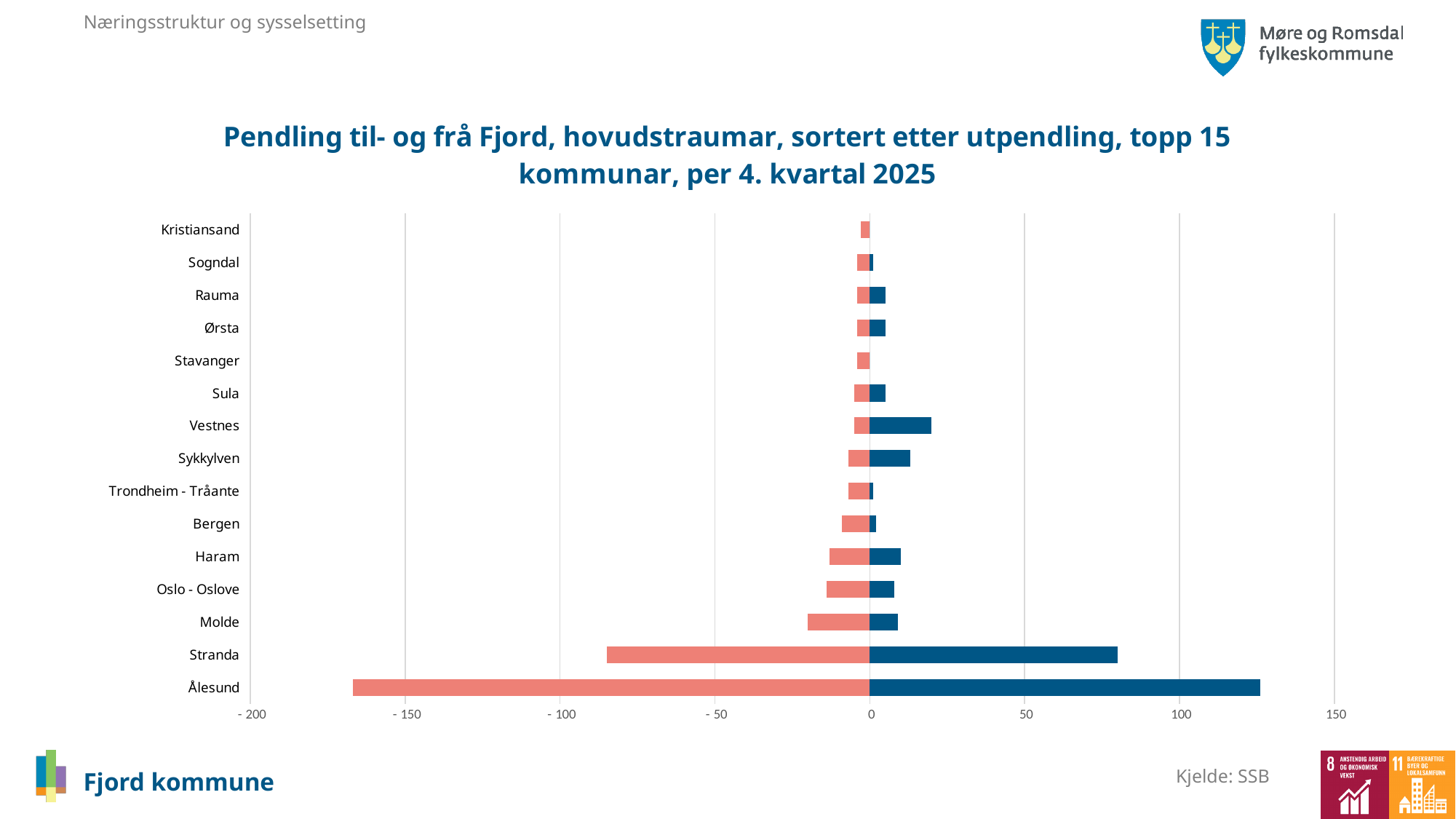
Is the blue bar value for Stranda greater or less than 50? greater Is the blue bar value for Vestnes greater or less than 50? less Is the red bar value for Molde greater or less than -50? greater Which municipality has the longest blue bar (largest positive value)? Ålesund What source is cited for the chart data? SSB Which municipality has the longest red bar (most negative value)? Ålesund What kind of chart is shown on the slide? bar chart Which has the larger blue bar, Stranda or Molde? Stranda How many municipalities (categories) are listed on the chart? 15